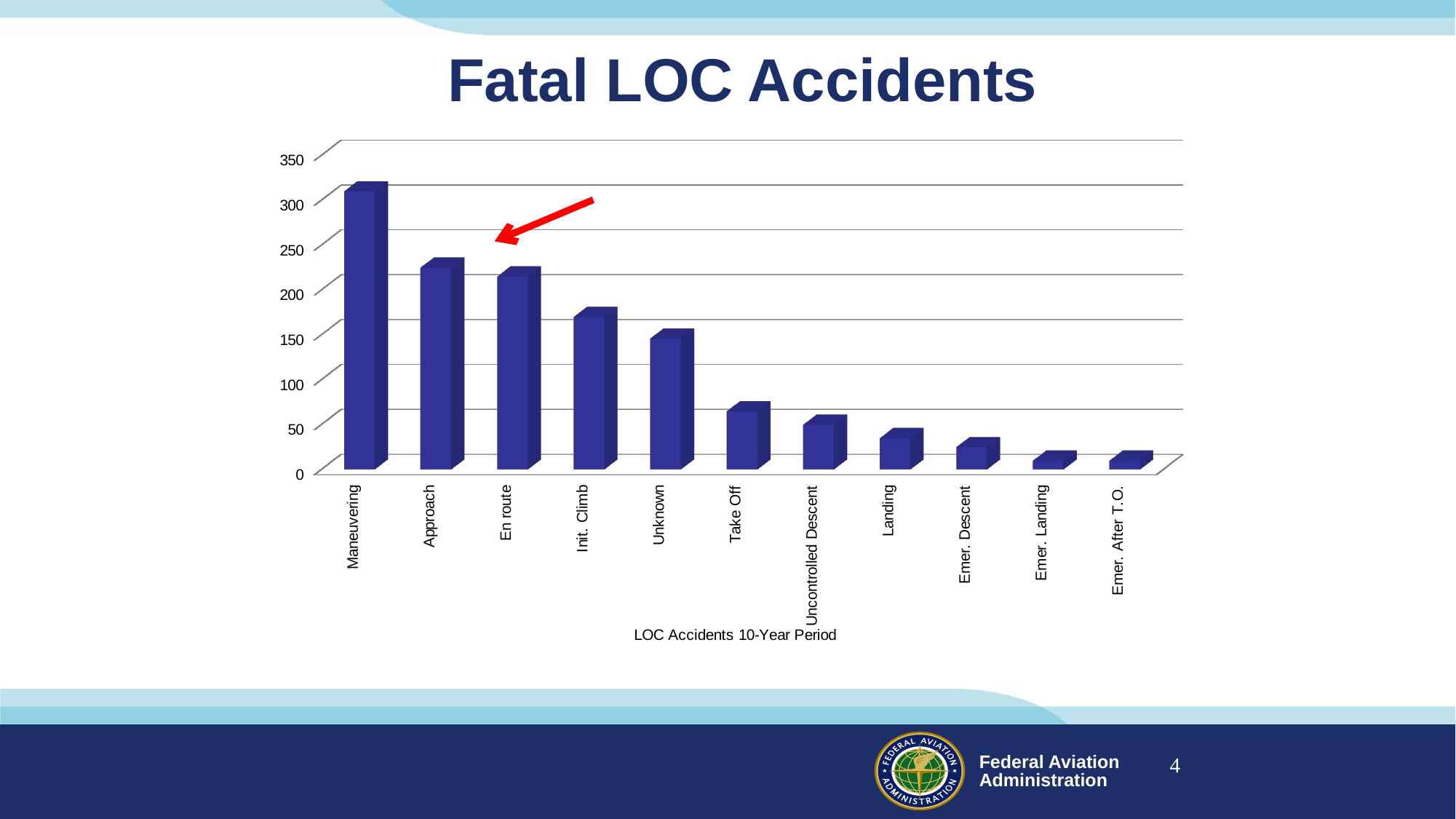
Is the value for Init. Climb greater or less than 150? greater Is the value for Take Off greater or less than 100? less How many categories are plotted on the x axis of the chart? 11 Do the bar values rise or fall moving from left to right along the x axis? Fall What kind of chart is shown on the slide? Bar chart Is the value for Approach greater or less than 200? greater Which is larger, the value for Init. Climb or the value for Unknown? Init. Climb What is the label shown beneath the x axis of the chart? LOC Accidents 10-Year Period Which is larger, the value for Maneuvering or the value for Approach? Maneuvering Which category has the highest number of fatal LOC accidents? Maneuvering